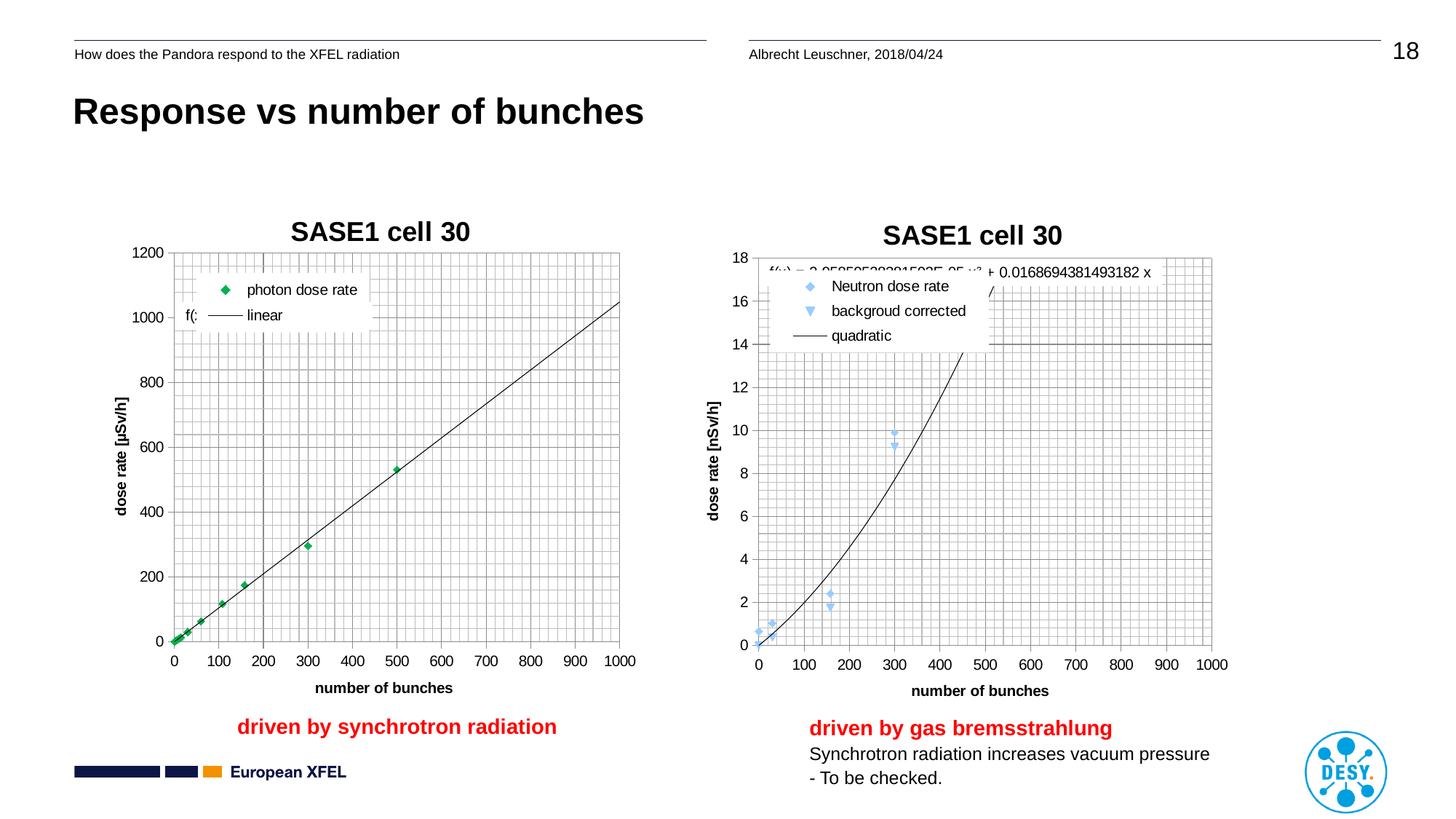
What kind of chart is the left chart titled "SASE1 cell 30"? scatter chart In the right chart, is the neutron dose rate at 300 bunches greater or less than 8? greater In the right chart, what is the label of the y axis? dose rate [nSv/h] In the left chart, what is the label of the y axis? dose rate [µSv/h] In the left chart, is the photon dose rate at 500 bunches greater or less than 400? greater In the right chart, does the neutron dose rate rise or fall as the number of bunches increases? rise In the right chart, is the neutron dose rate at about 160 bunches greater or less than 4? less How many entries does the legend of the right chart list? 3 How many entries does the legend of the left chart list? 2 In the left chart, does the photon dose rate rise or fall as the number of bunches increases? rise In the left chart, at which number of bunches is the photon dose rate highest? 500